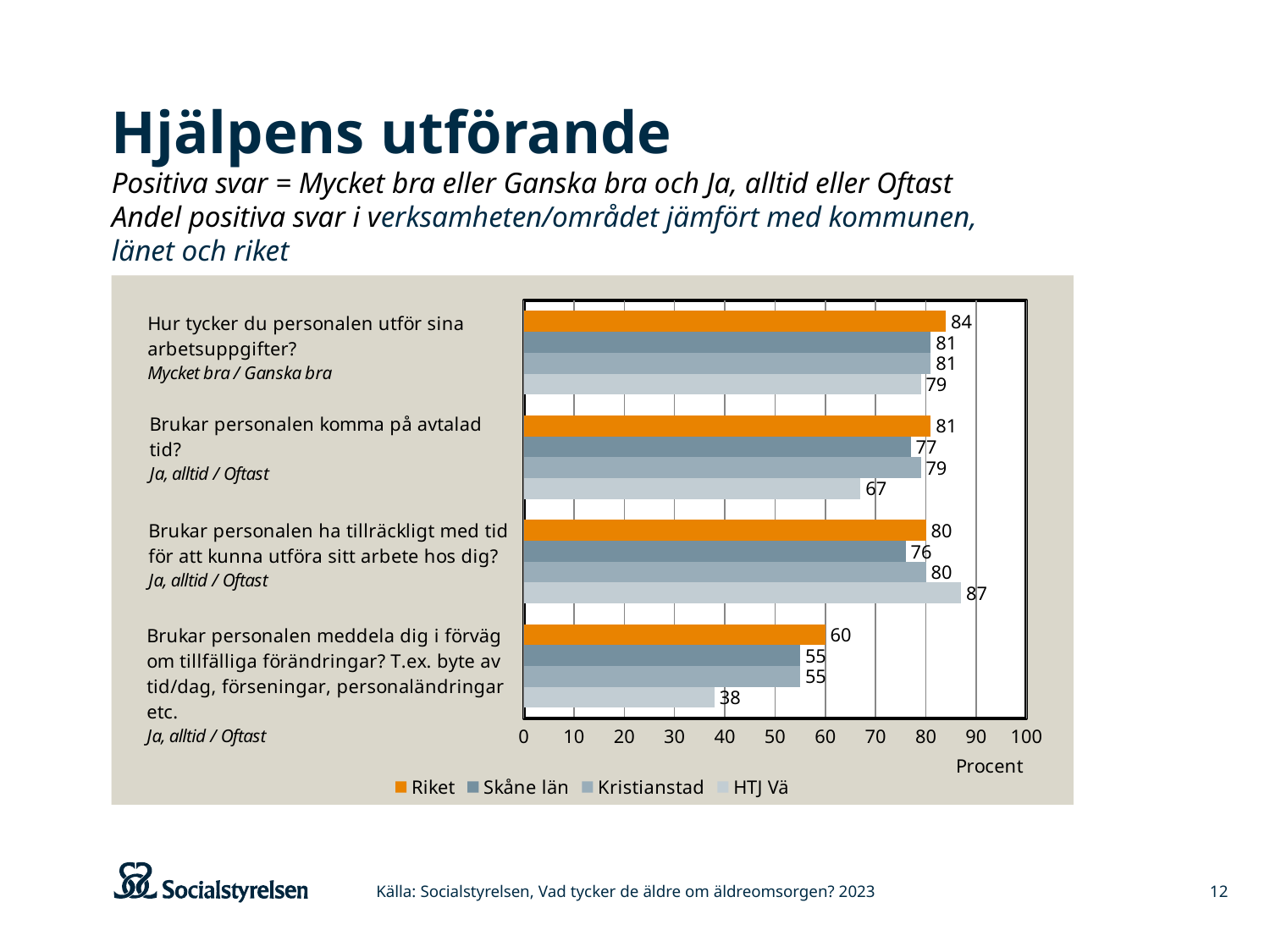
What is the value for Skåne län on the question "Brukar personalen meddela dig i förväg om tillfälliga förändringar?"? 55 What is the difference between Riket and HTJ Vä on the question "Brukar personalen meddela dig i förväg om tillfälliga förändringar?"? 22 What is the value for HTJ Vä on the question "Brukar personalen ha tillräckligt med tid för att kunna utföra sitt arbete hos dig?"? 87 What is the label of the horizontal axis? Procent What kind of chart is shown on the slide? Bar chart How many question categories are shown in the chart? 4 On the question "Brukar personalen komma på avtalad tid?", which is larger: Kristianstad or Skåne län? Kristianstad What is the value for HTJ Vä on the question "Brukar personalen komma på avtalad tid?"? 67 How many series does the legend list? 4 Which series has the lowest value on the question "Brukar personalen meddela dig i förväg om tillfälliga förändringar?"? HTJ Vä Which series has the highest value on the question "Brukar personalen ha tillräckligt med tid för att kunna utföra sitt arbete hos dig?"? HTJ Vä What is the value for Riket on the question "Hur tycker du personalen utför sina arbetsuppgifter?"? 84